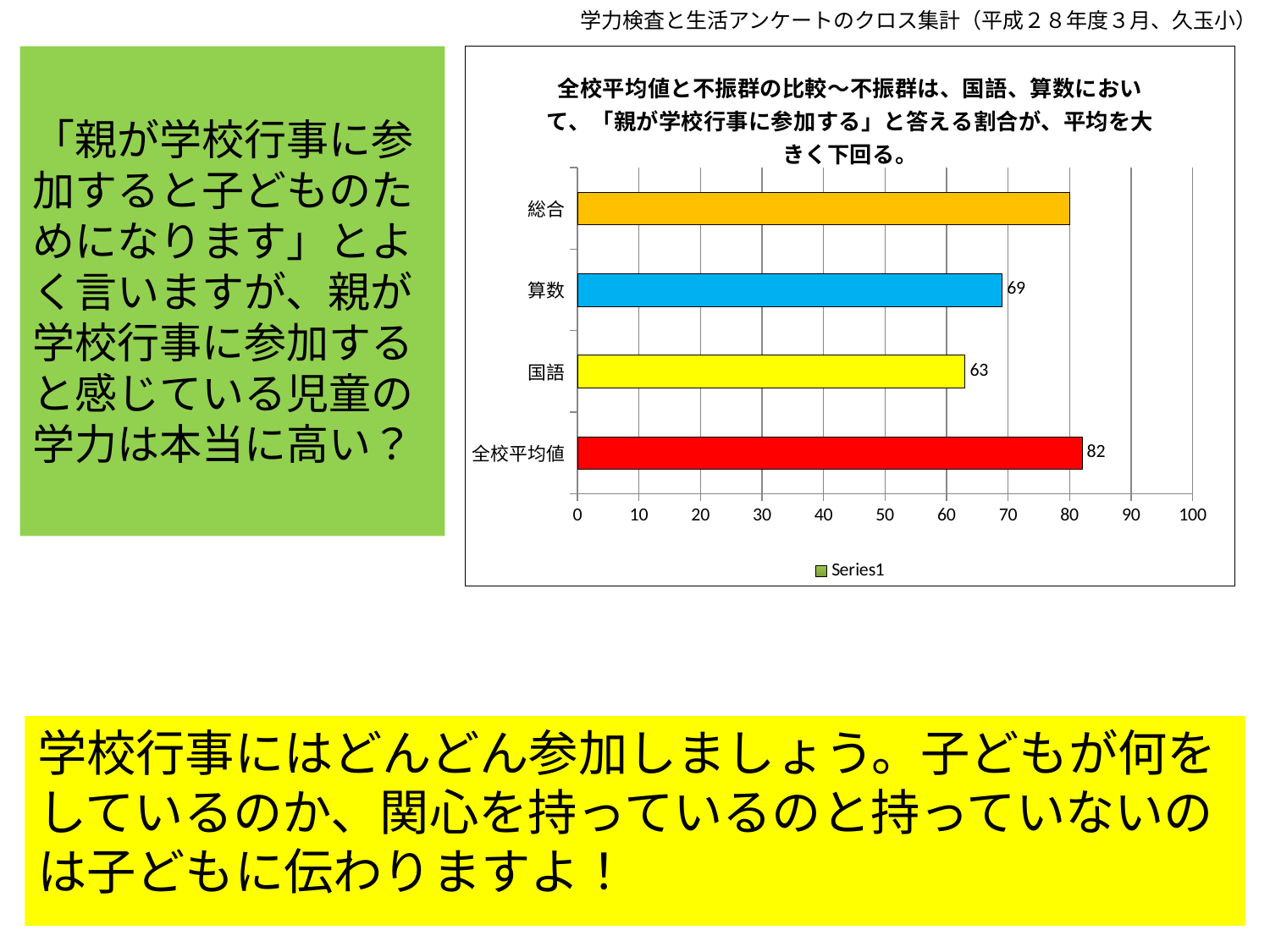
What is the value for 国語? 63 Which category has the lowest value? 国語 What is the difference between the values for 算数 and 国語? 6 What is the value for 算数? 69 Is the value for 総合 greater or less than 70? greater What is the value for 全校平均値? 82 What kind of chart is shown on the slide? bar chart How many categories are shown in the chart? 4 What is the difference between the values for 全校平均値 and 国語? 19 Which is larger, the value for 算数 or the value for 国語? 算数 What colour is the bar for 全校平均値? red How many series does the legend list? 1